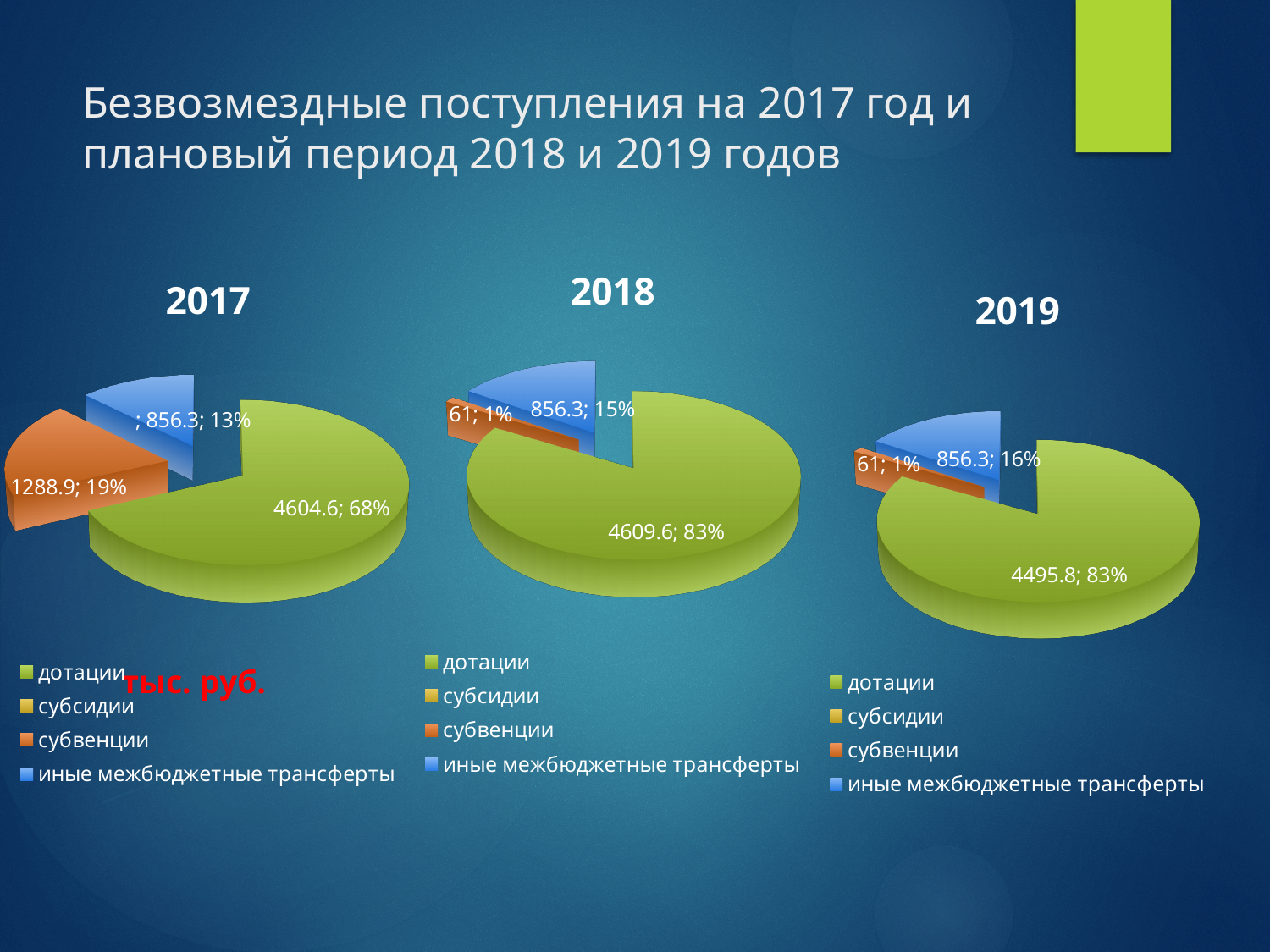
How many entries does the legend of the 2019 chart list? 4 In the 2017 pie chart, which of the labelled slices is the smallest? иные межбюджетные трансферты In the 2018 pie chart, what is the value for субвенции? 61 In the 2019 pie chart, what is the value for дотации? 4495.8 In the 2018 pie chart, which category has the largest slice? дотации In the 2017 pie chart, what is the value for дотации? 4604.6 In the 2017 pie chart, what is the difference between the value for субвенции and the value for иные межбюджетные трансферты? 432.6 In the 2019 pie chart, what share of the pie do иные межбюджетные трансферты take? 16% In the 2017 pie chart, what share of the pie do субвенции take? 19% In the 2017 pie chart, which is larger: субвенции or иные межбюджетные трансферты? субвенции In the 2018 pie chart, which category is shown in blue? иные межбюджетные трансферты What type of chart is used for the 2018 data? pie chart